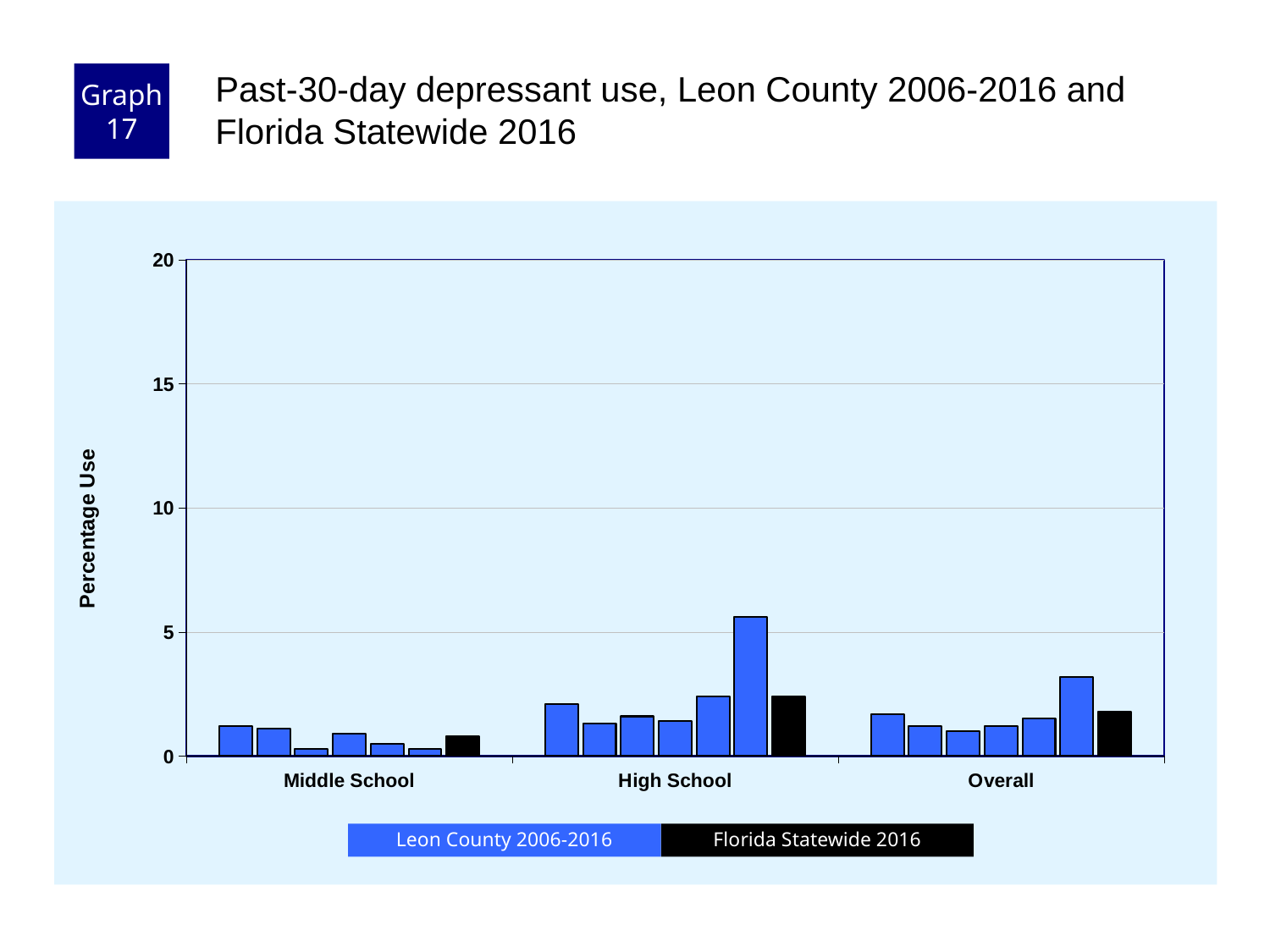
How many series does the legend list? 2 Which is larger, the Florida Statewide 2016 value for High School or for Middle School? High School Which category group contains the tallest bar on the chart? High School Is the highest value on the chart greater or less than 10? less Which category group has the lowest bars overall? Middle School Is the tallest Leon County 2006-2016 bar in the High School group greater or less than 5? greater How many bars are plotted in the High School group? 7 What is the label on the y axis? Percentage Use Is the Florida Statewide 2016 value for High School greater or less than 5? less What kind of chart is shown on the slide? bar chart How many category groups are shown along the x axis? 3 What colour represents Florida Statewide 2016 in the legend? black